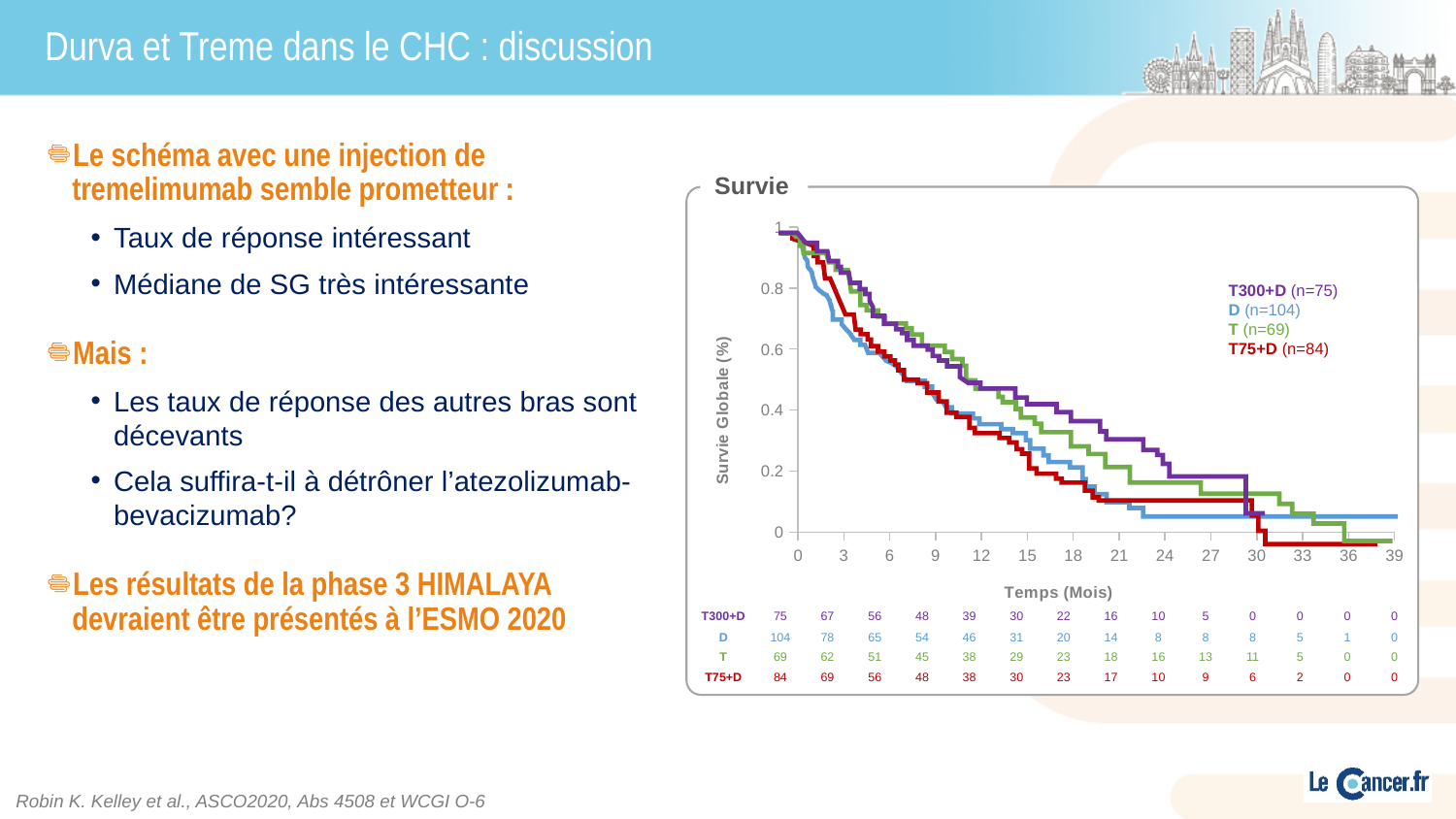
In the number-at-risk table, how many patients in the T arm are at risk at 12 months? 38 Do the survival curves rise or fall as time (months) increases? fall What is the difference between the number at risk at time 0 for the D arm and the T300+D arm? 29 Is the T300+D survival curve at 6 months greater or less than 0.4? greater How many series does the legend of the survival chart list? 4 What kind of chart is shown under the title "Survie"? line chart At 24 months, which arm has more patients at risk, T or D? T Which arm has the largest number of patients (n) in the legend? D What is the title of the x axis of the survival chart? Temps (Mois) Which arm has the smallest number of patients (n) in the legend? T According to the legend, how many patients (n) are in the D arm? 104 In the number-at-risk table, how many patients in the T300+D arm are at risk at 27 months? 5